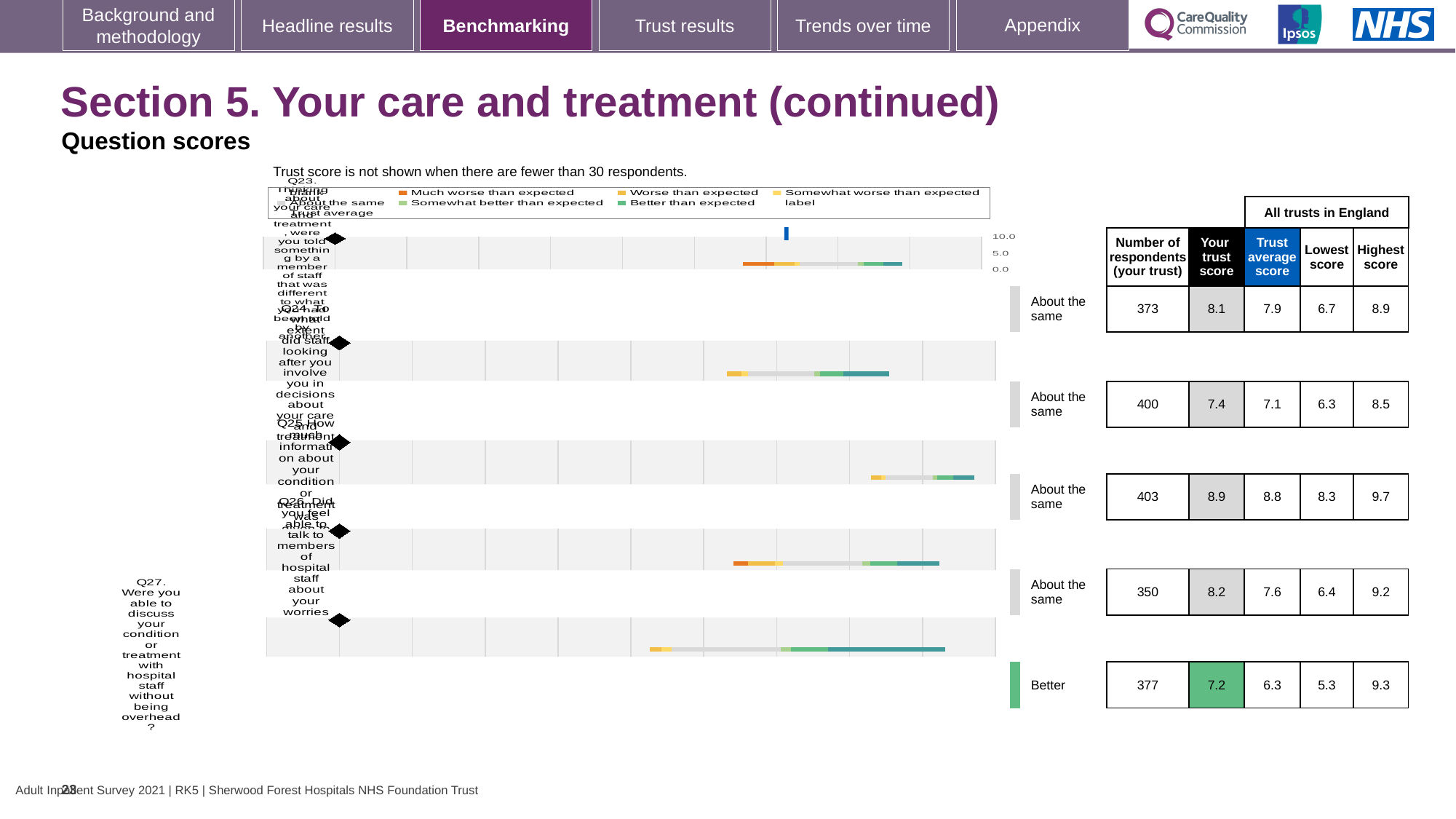
What is the trust score for Q27 (discussing your condition or treatment without being overheard)? 7.2 For Q27, which is larger: your trust score or the trust average score? Your trust score Which question is rated 'Better' rather than 'About the same'? Q27 What kind of chart is used to show the benchmarking results? Bar chart What is the difference between the trust score and the trust average score for Q23? 0.2 Which question has the highest 'Your trust score' on this slide? Q25 How many questions are benchmarked on this slide? 5 What is the highest score among all trusts in England for Q25? 9.7 How many respondents (your trust) are shown for Q23? 373 What is the trust average score for Q24? 7.1 What is the lowest score among all trusts in England for Q26? 6.4 Which question has the lowest 'Your trust score' on this slide? Q27